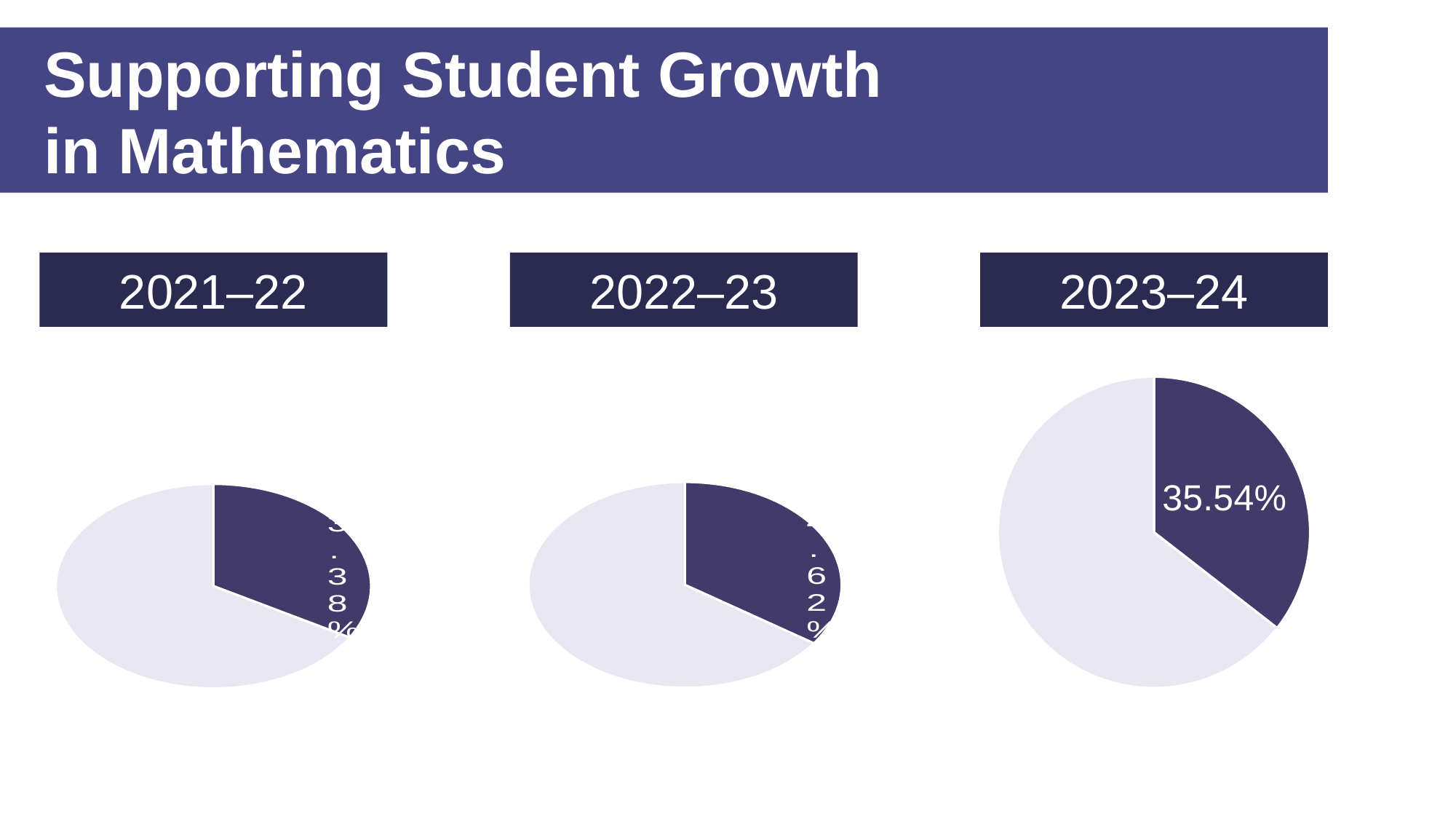
In the 2022–23 pie chart, which slice is larger, the dark slice or the light slice? The light slice In the 2021–22 pie chart, which slice is larger, the dark slice or the light slice? The light slice In the 2023–24 pie chart, what percentage is printed on the dark slice? 35.54% What is the title of the slide containing the pie charts? Supporting Student Growth in Mathematics What kind of chart is used for the 2023–24 data? Pie chart How many slices does the 2023–24 pie chart have? 2 Which school years are labelled above the three pie charts? 2021–22, 2022–23, 2023–24 In the 2023–24 pie chart, which slice is larger, the dark slice or the light slice? The light slice In the 2023–24 pie chart, what share of the pie does the light slice represent? 64.46% How many pie charts are shown on the slide? 3